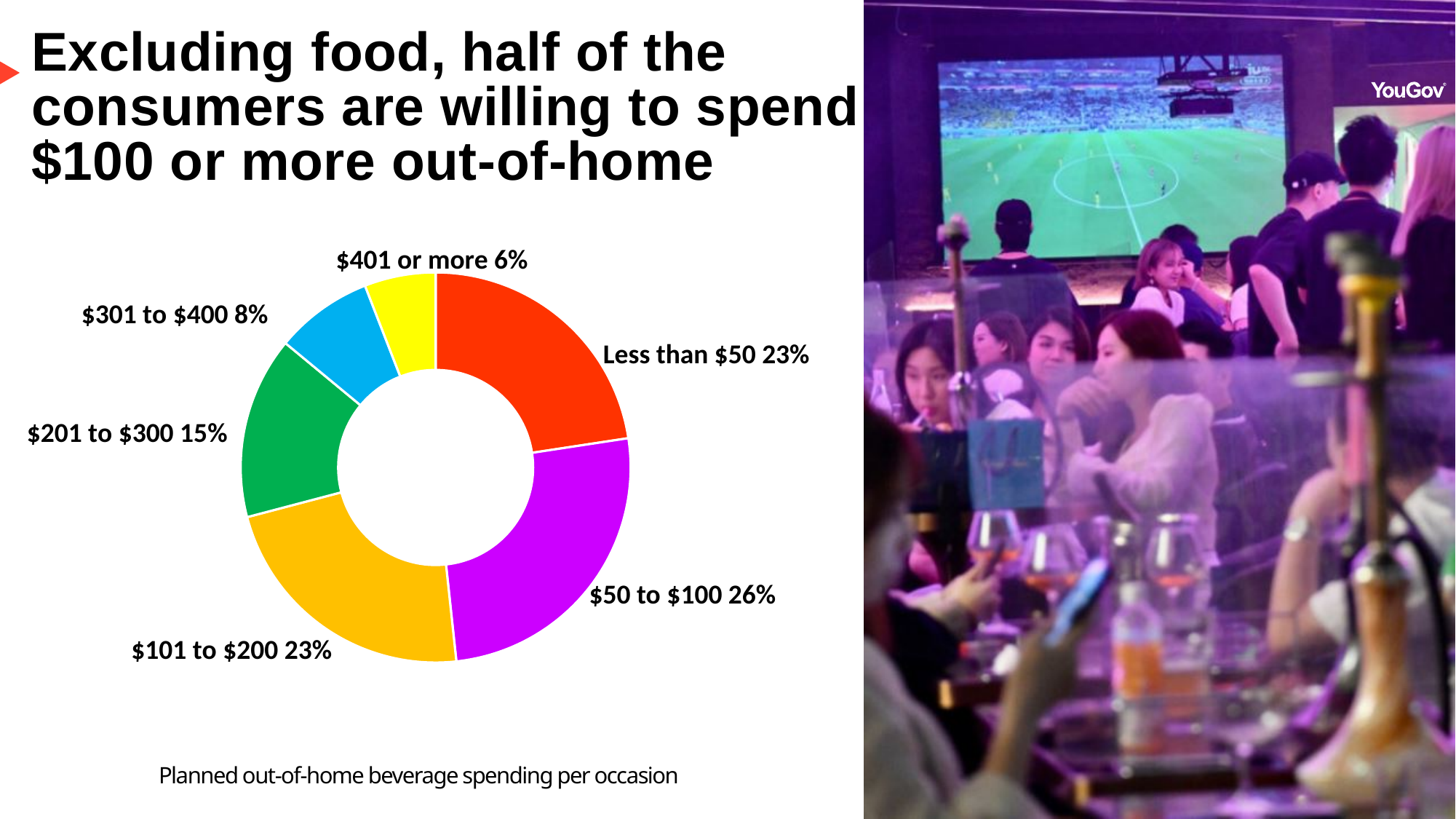
What kind of chart is shown on the slide? Doughnut chart Which spending band has the largest share? $50 to $100 What colour is the slice for $101 to $200? Yellow-orange What share of consumers plan to spend $401 or more? 6% What is the combined share of the $301 to $400 and $401 or more bands? 14% How many spending bands are shown in the chart? 6 What share of consumers plan to spend $50 to $100 on out-of-home beverages per occasion? 26% What share of consumers plan to spend less than $50? 23% What share of consumers plan to spend $201 to $300? 15% Which is larger: the share for $101 to $200 or the share for $301 to $400? $101 to $200 What is the difference in percentage points between the $201 to $300 band and the $301 to $400 band? 7 Which spending band has the smallest share? $401 or more